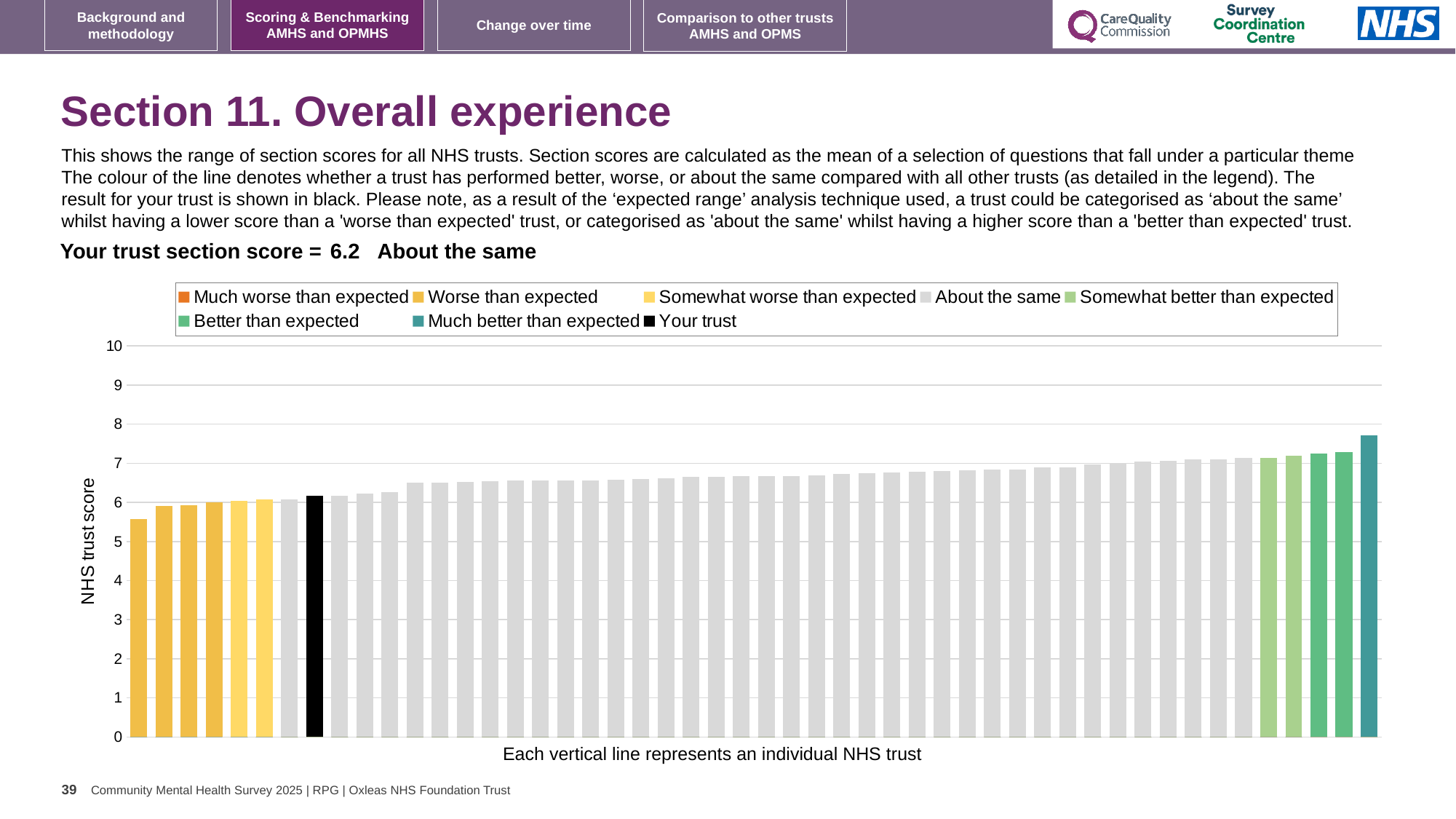
How many bars are coloured as 'Much better than expected'? 1 Which legend category does the tallest bar belong to? Much better than expected Which category is your trust's section score placed in? About the same Is the value of the tallest bar greater or less than 7? greater Is the value of the black 'Your trust' bar greater or less than 7? less Is the value of the shortest bar greater or less than 6? less What is the section score for your trust shown on the slide? 6.2 What is the label on the vertical axis of the chart? NHS trust score How many entries does the chart legend list? 8 What is the label below the horizontal axis of the chart? Each vertical line represents an individual NHS trust Do the bar values rise or fall from left to right across the chart? rise What kind of chart is shown on the slide? bar chart